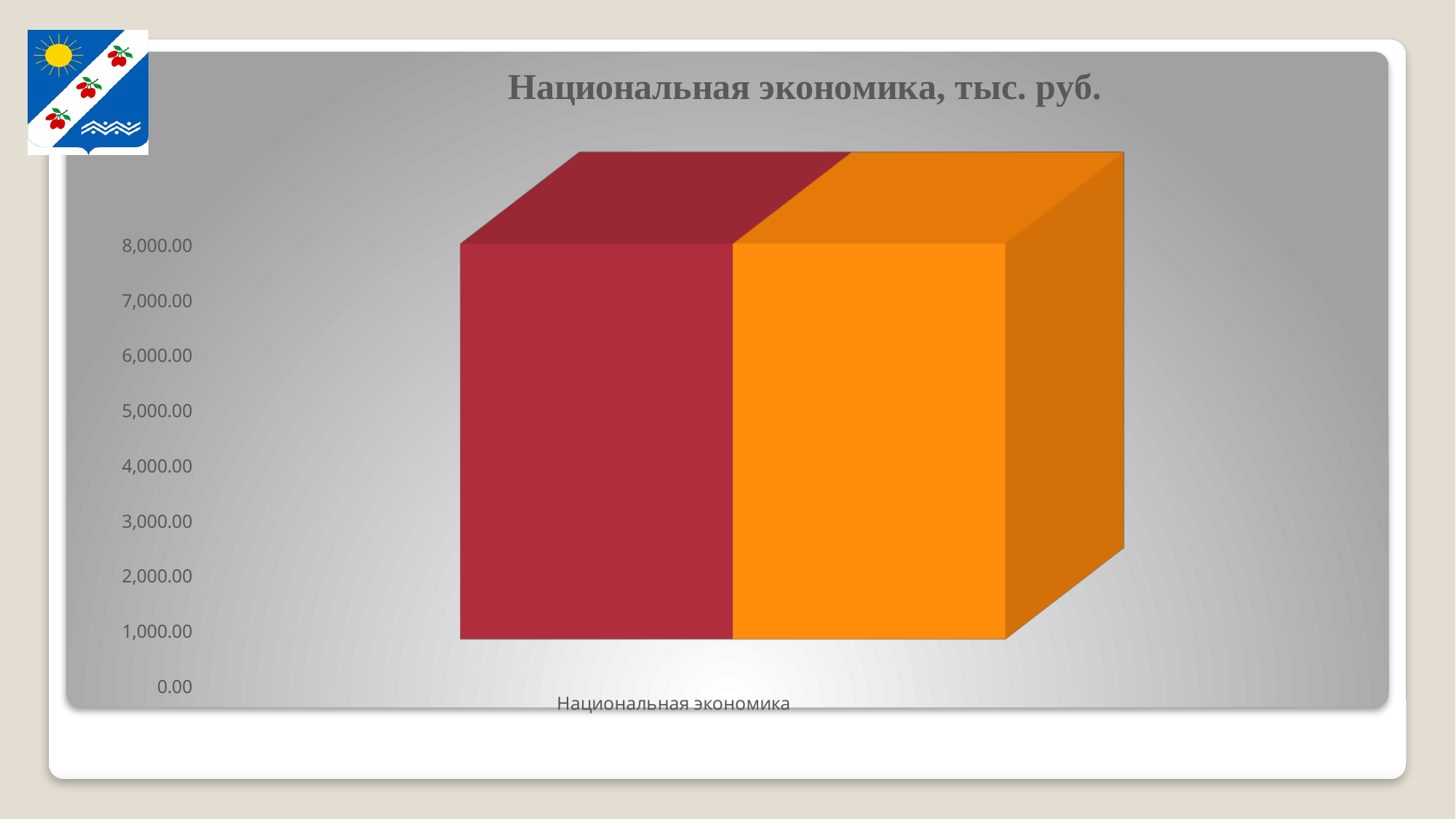
What kind of chart is shown on the slide? bar chart What is the highest tick value shown on the vertical axis? 8,000.00 Is the value of the orange bar greater or less than 4,000.00? greater Is the value of the orange bar greater or less than 6,000.00? greater How many categories are shown on the x axis of the chart? 1 Is the value of the red bar greater or less than 6,000.00? greater What is the title of the chart? Национальная экономика, тыс. руб. How many bars are plotted in the chart? 2 What is the label of the category on the x axis? Национальная экономика